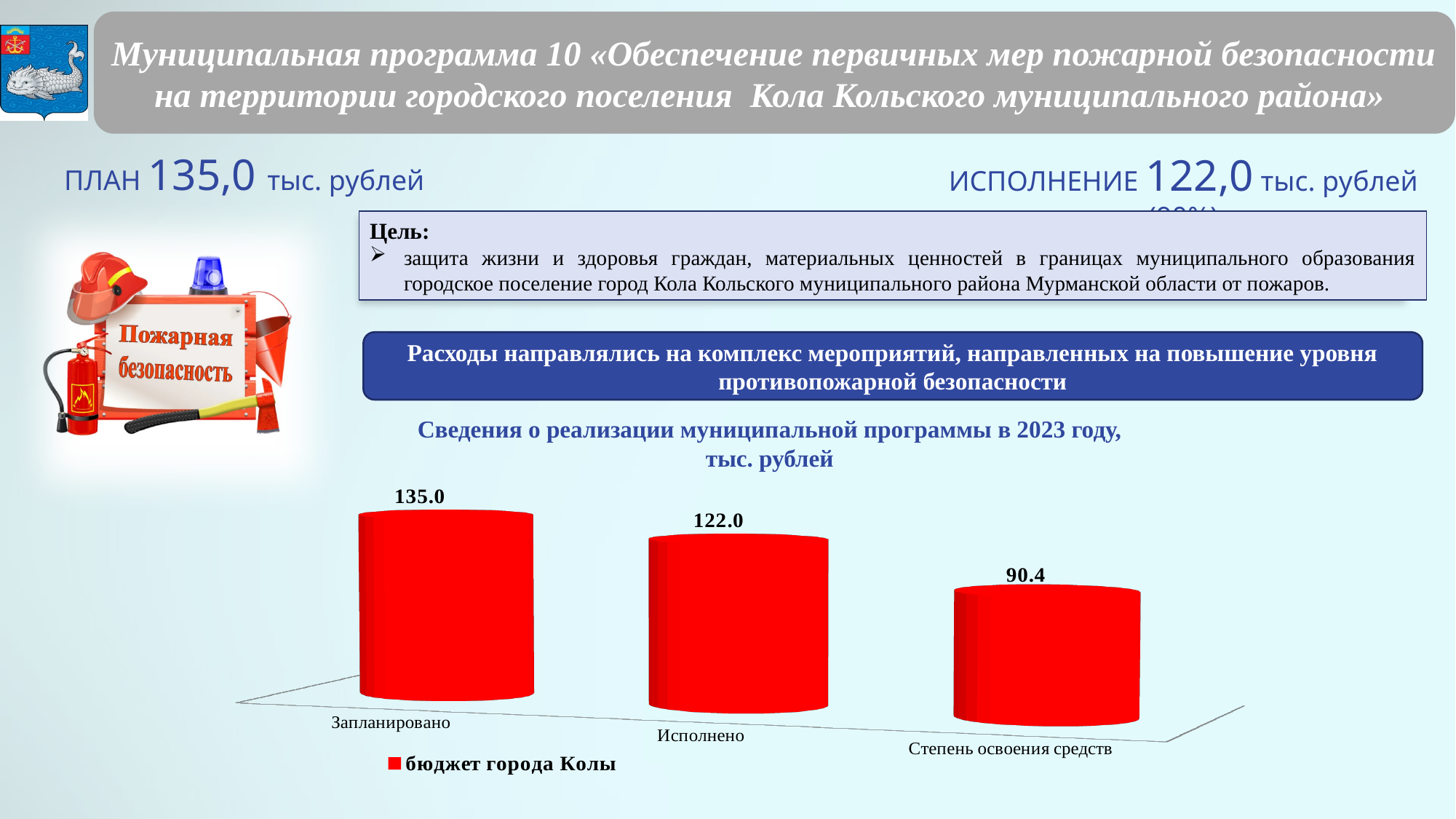
What is the name of the series in the legend? бюджет города Колы Which category has the highest value? Запланировано Which is larger, Исполнено or Степень освоения средств? Исполнено How many categories are shown in the chart? 3 What kind of chart is shown? Bar chart What is the value for Запланировано? 135.0 How many series does the legend list? 1 What is the value for Исполнено? 122.0 Which category has the lowest value? Степень освоения средств What is the value for Степень освоения средств? 90.4 Do the values rise or fall from left to right across the categories? Fall What is the difference between Запланировано and Исполнено? 13.0